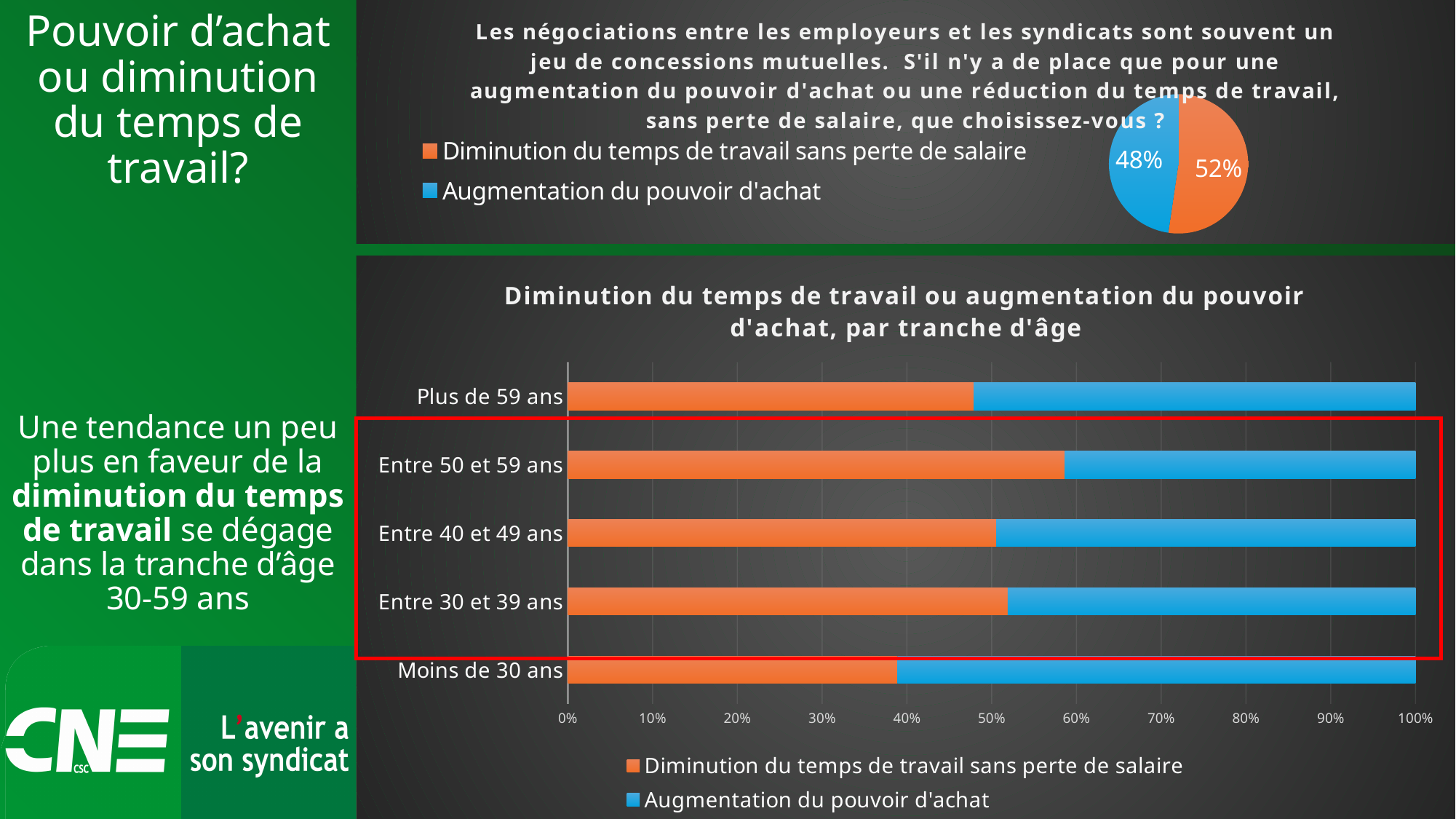
In the pie chart at the top of the slide, which option has the larger share? Diminution du temps de travail sans perte de salaire In the chart by age group, is the share for 'Diminution du temps de travail sans perte de salaire' among 'Entre 50 et 59 ans' greater or less than 50%? greater In the chart by age group, which colour represents 'Augmentation du pouvoir d'achat'? Blue In the chart by age group, is the share for 'Diminution du temps de travail sans perte de salaire' among 'Moins de 30 ans' greater or less than 40%? less What kind of chart is the chart titled 'Diminution du temps de travail ou augmentation du pouvoir d'achat, par tranche d'âge'? Stacked bar chart How many age groups are shown in the chart 'Diminution du temps de travail ou augmentation du pouvoir d'achat, par tranche d'âge'? 5 How many series does the legend of the chart 'Diminution du temps de travail ou augmentation du pouvoir d'achat, par tranche d'âge' list? 2 In the pie chart at the top of the slide, what is the difference between the two slices? 4% In the chart by age group, which age group has the largest share for 'Diminution du temps de travail sans perte de salaire'? Entre 50 et 59 ans In the pie chart at the top of the slide, what share is shown for 'Diminution du temps de travail sans perte de salaire'? 52% In the pie chart at the top of the slide, what share is shown for 'Augmentation du pouvoir d'achat'? 48% In the chart by age group, which age group has the smallest share for 'Diminution du temps de travail sans perte de salaire'? Moins de 30 ans